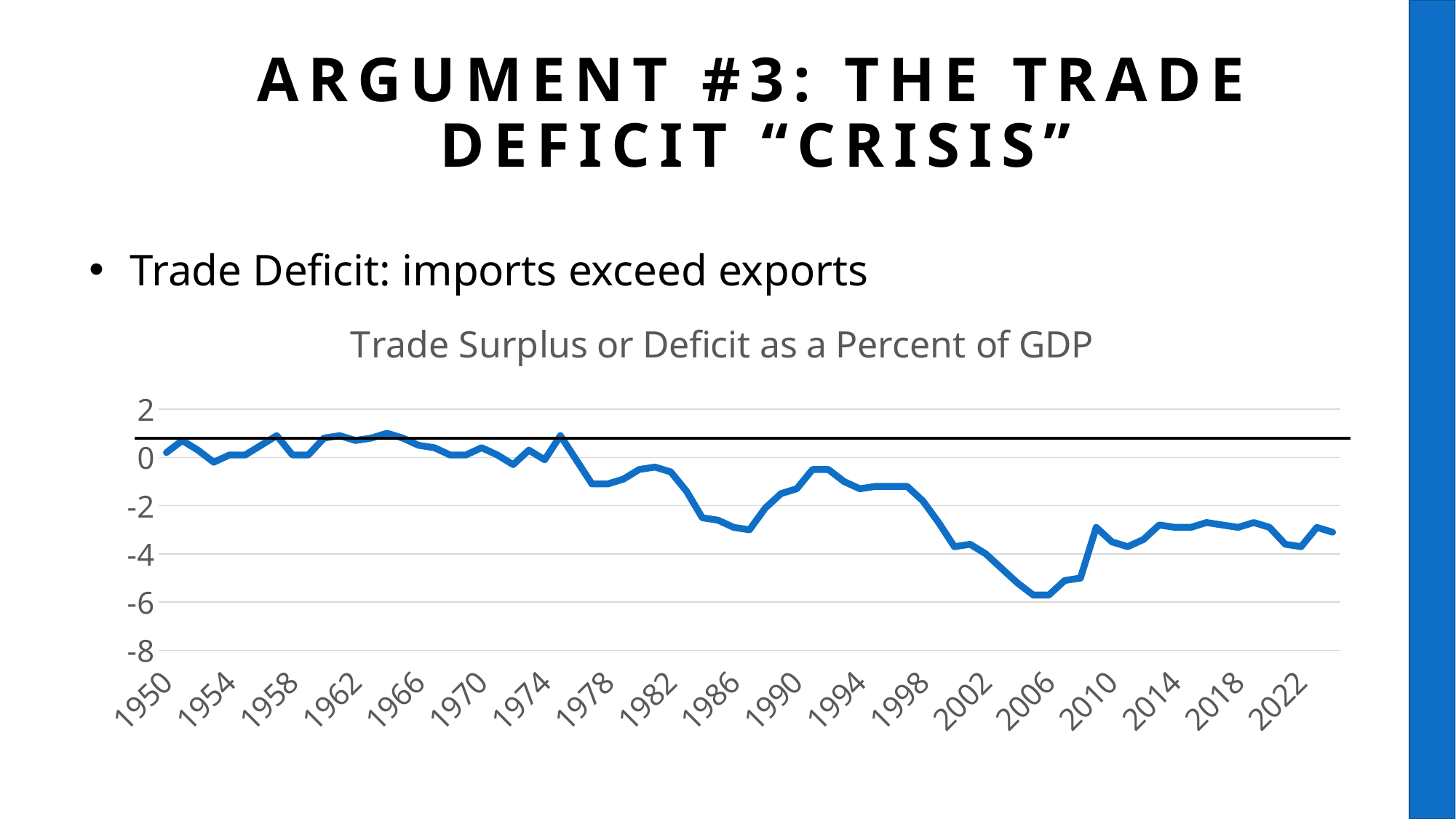
What is the title of the chart? Trade Surplus or Deficit as a Percent of GDP Is the value for 2014 greater or less than -2? less Is the value for 1990 greater or less than -2? greater Which year has the larger value, 1990 or 2006? 1990 Is the value for 2006 greater or less than -4? less What kind of chart is shown on the slide? line chart In which year shown on the x axis does the line reach its lowest value? 2006 Do the values generally rise or fall between 1998 and 2006? fall Do the values generally rise or fall between 2006 and 2010? rise What is the lowest value labelled on the y axis? -8